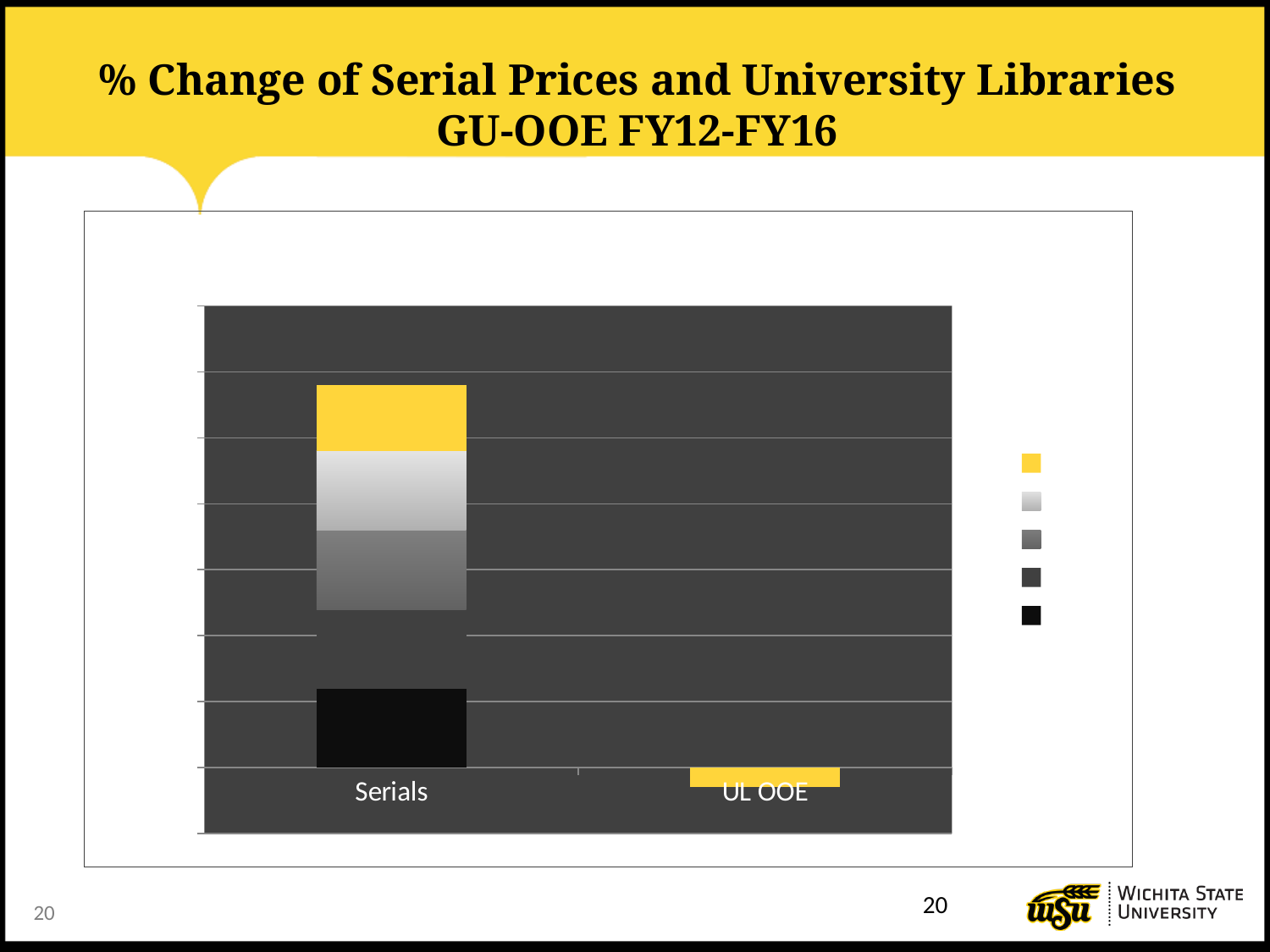
Which category has the lowest stacked bar in the chart? UL OOE Which category's bar extends below the baseline of the chart? UL OOE How many categories are shown on the x axis of the chart? 2 Which category has the highest stacked bar in the chart? Serials How many series does the chart's legend list? 5 What is the title of the slide containing the chart? % Change of Serial Prices and University Libraries GU-OOE FY12-FY16 What kind of chart is shown on the slide? Stacked bar chart What colour is the topmost segment of the Serials bar? Yellow Which category has the taller stacked bar, Serials or UL OOE? Serials